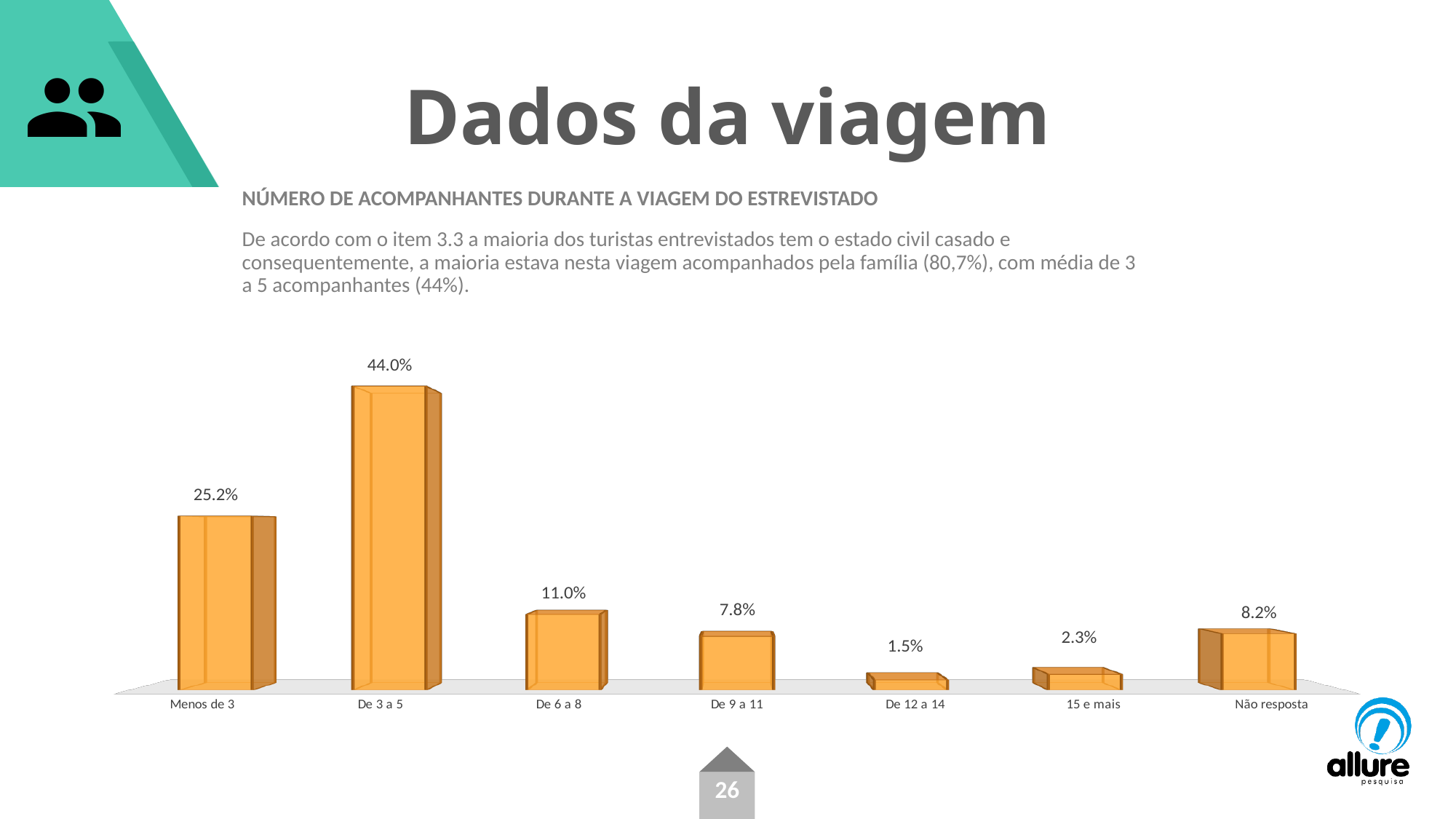
Which category has the highest value? De 3 a 5 What kind of chart is shown on the slide? Bar chart What is the difference between the values for '15 e mais' and 'De 12 a 14'? 0.8% Which category has the lowest value? De 12 a 14 What is the value for 'De 12 a 14'? 1.5% Which is larger, the value for 'De 6 a 8' or the value for 'Não resposta'? De 6 a 8 What is the difference between the values for 'De 3 a 5' and 'Menos de 3'? 18.8% How many categories are shown on the x axis? 7 What is the value for 'Menos de 3'? 25.2% What is the value for 'De 3 a 5'? 44.0% What is the value for 'Não resposta'? 8.2% What is the subtitle printed above the chart? NÚMERO DE ACOMPANHANTES DURANTE A VIAGEM DO ESTREVISTADO